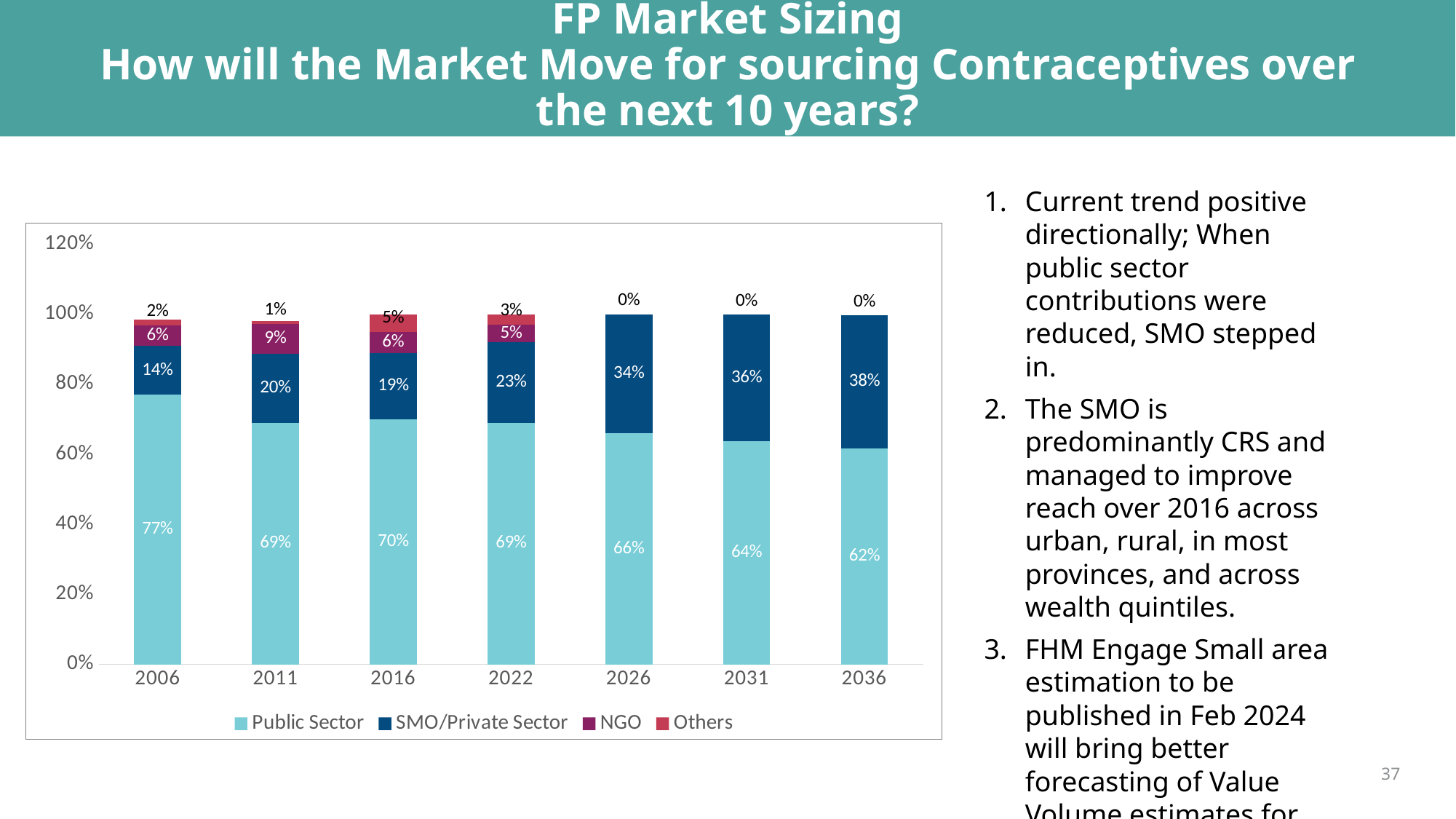
Which year has the larger Public Sector share, 2011 or 2016? 2016 By how many percentage points does the SMO/Private Sector share in 2036 exceed that in 2006? 24% How many years are shown on the x axis? 7 What is the NGO share in 2011? 9% What is the Public Sector share in 2006? 77% In which year is the Public Sector share lowest? 2036 What is the SMO/Private Sector share in 2036? 38% What kind of chart is shown? Stacked bar chart In which year is the Public Sector share highest? 2006 Does the SMO/Private Sector share rise or fall from 2006 to 2036? Rise What is the Others share in 2016? 5% How many series does the legend list? 4